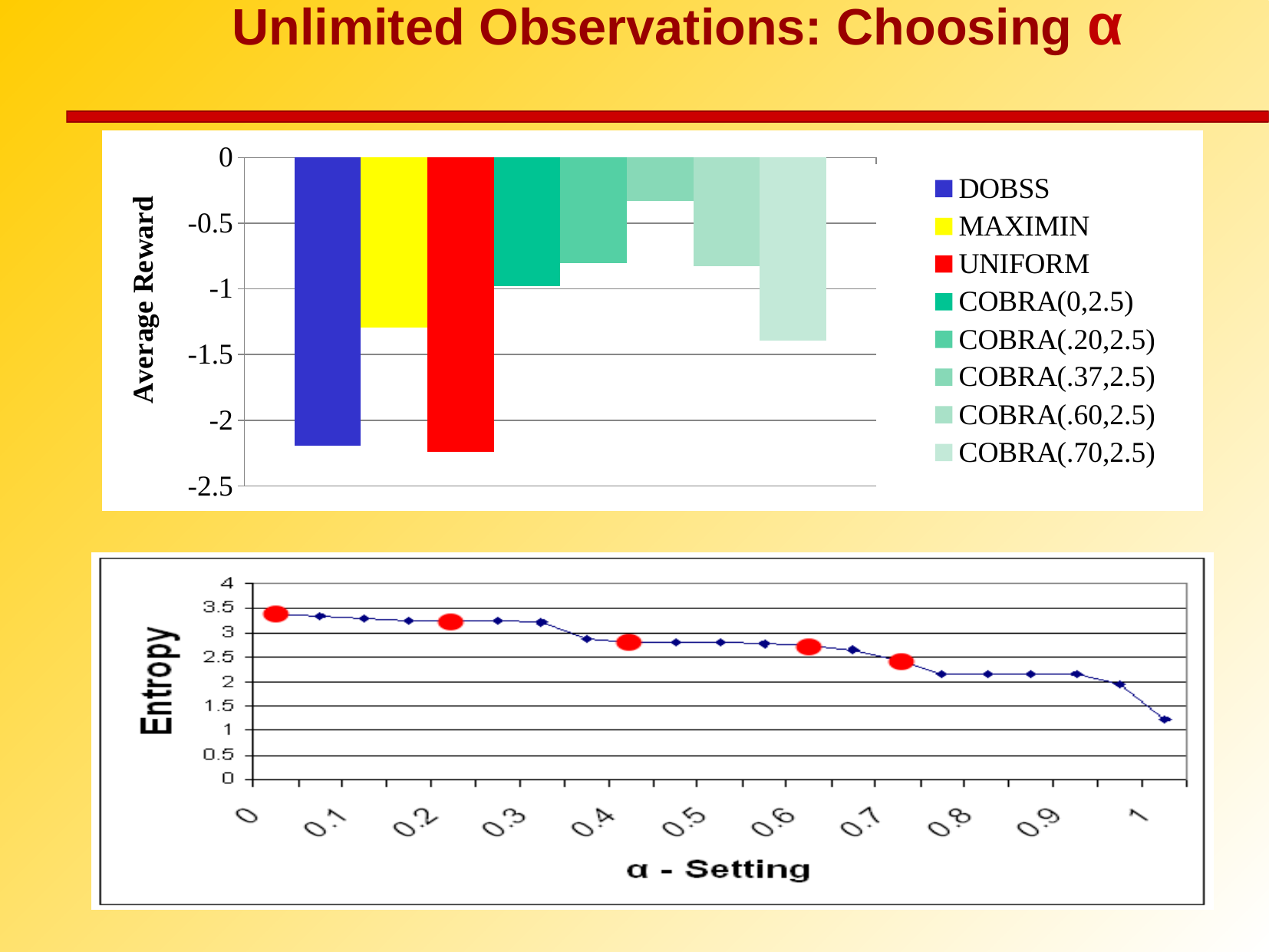
In the Average Reward bar chart, is the value for COBRA(.37,2.5) greater or less than -0.5? greater In the lower Entropy chart, is the entropy at α = 0.8 greater or less than 2.5? less What kind of chart is the lower chart showing Entropy against α - Setting? line chart In the Average Reward bar chart, how many series does the legend list? 8 In the Average Reward bar chart, is the value for DOBSS greater or less than -2? less In the Average Reward bar chart, which is larger, the value for MAXIMIN or the value for DOBSS? MAXIMIN In the lower Entropy chart, do the values rise or fall as α - Setting increases? fall In the Average Reward bar chart, which series has the highest (least negative) average reward? COBRA(.37,2.5) In the Average Reward bar chart, which is larger, the value for COBRA(.37,2.5) or the value for COBRA(.70,2.5)? COBRA(.37,2.5)